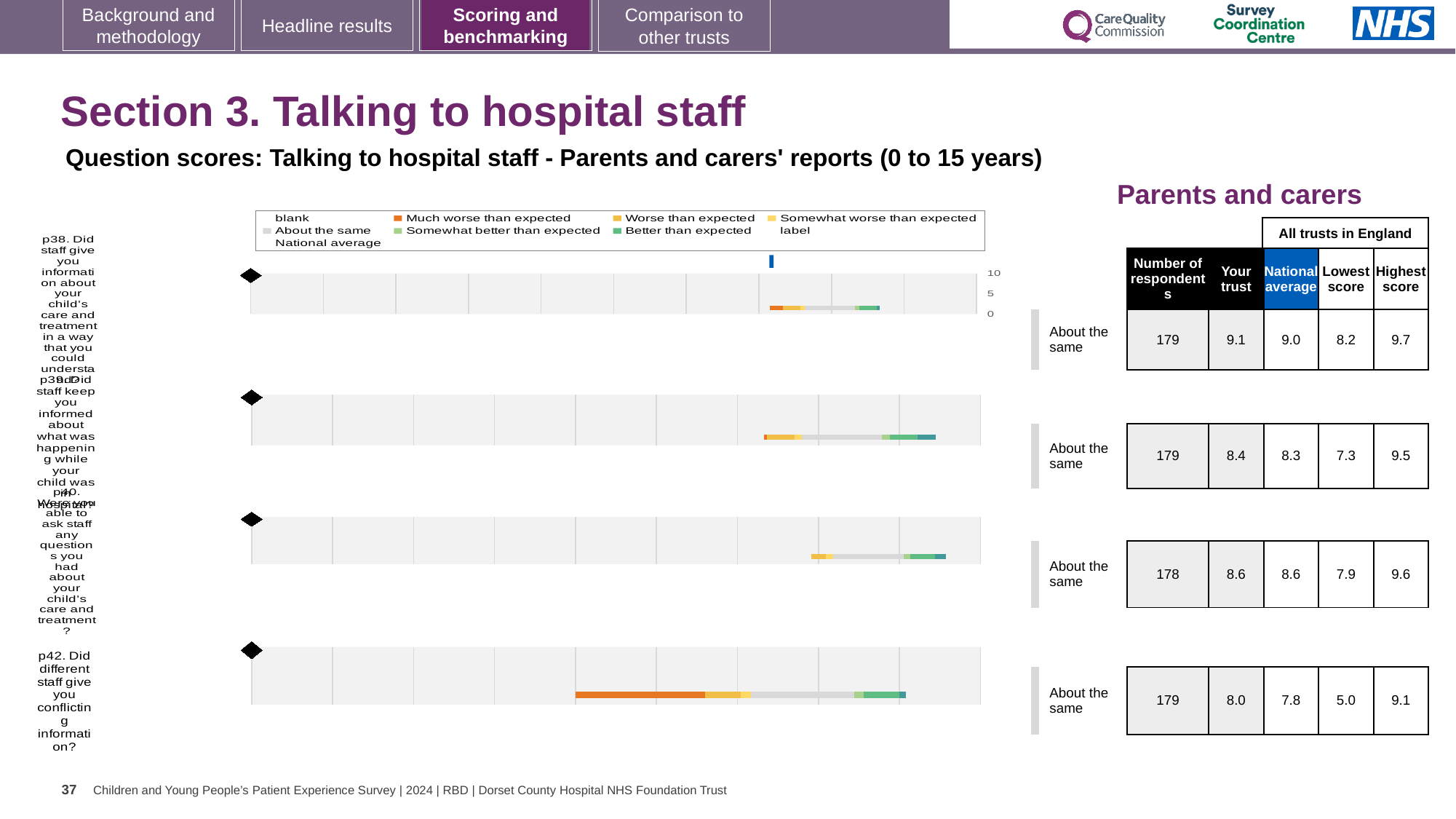
In the table beside the charts, what is the Lowest score for p39 (Did staff keep you informed about what was happening while your child was in hospital)? 7.3 In the table beside the charts, what is the difference between the Highest score and the Lowest score for p42? 4.1 In the table beside the charts, what is the Highest score for p40 (Were you able to ask staff any questions you had about your child's care and treatment)? 9.6 In the table beside the charts, what is the National average for p42 (Did different staff give you conflicting information)? 7.8 In the table beside the charts, what is the 'Your trust' score for p38 (Did staff give you information about your child's care and treatment in a way that you could understand)? 9.1 In the table beside the charts, how many respondents are listed for p40? 178 How many question charts (p38, p39, p40, p42) are shown on the slide? 4 What kind of chart is used to show the question scores on this slide? bar chart How many entries does the legend above the charts list? 9 In the table beside the charts, is the 'Your trust' score for p39 larger or smaller than the National average for p39? larger In the table beside the charts, which question has the lowest 'Your trust' score? p42 Which colour does the legend use for 'Much worse than expected'? orange